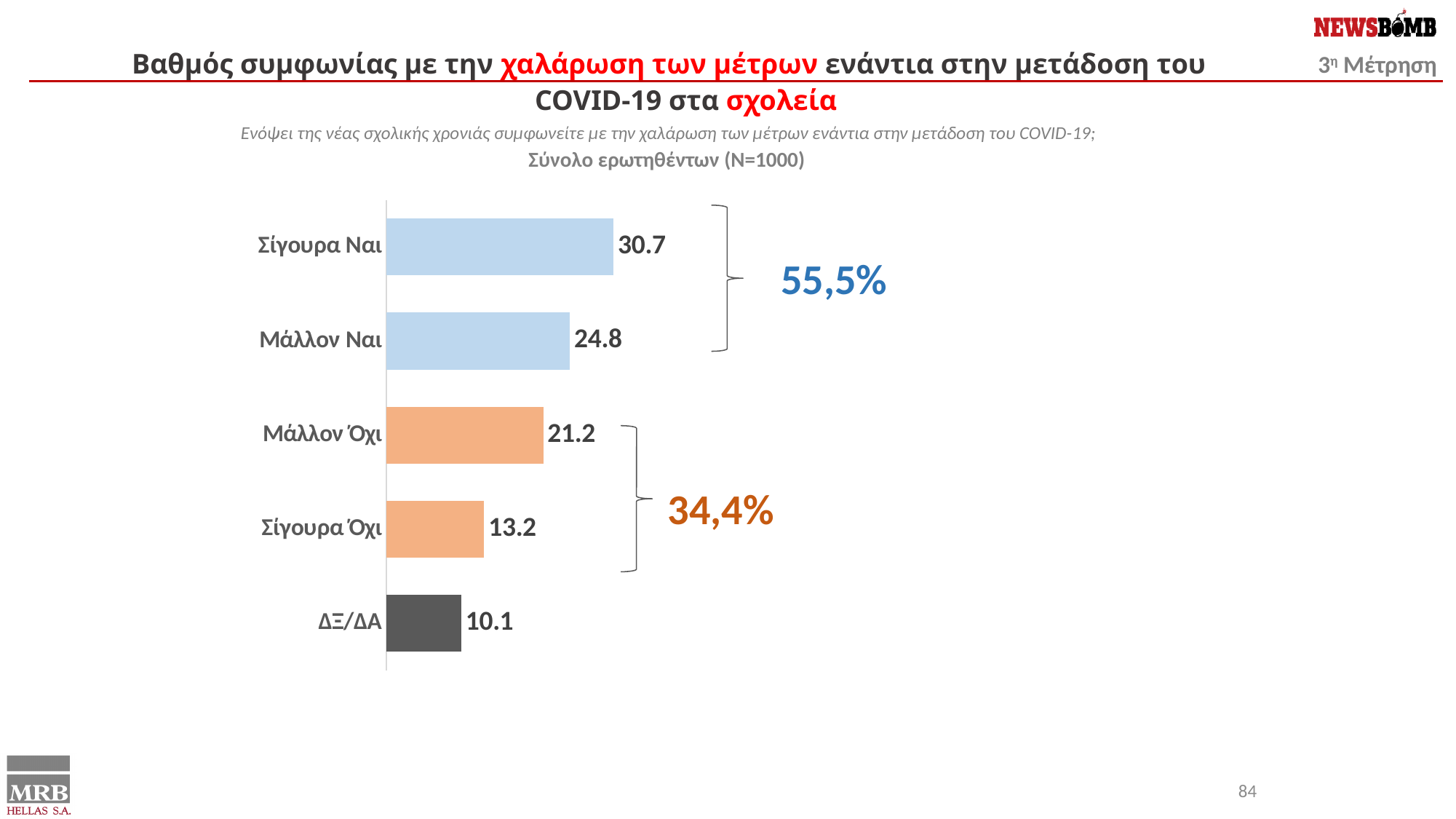
What combined percentage is shown next to the bracket grouping Μάλλον Όχι and Σίγουρα Όχι? 34,4% Which is larger, the value for Μάλλον Ναι or the value for Μάλλον Όχι? Μάλλον Ναι Which category has the lowest value? ΔΞ/ΔΑ What kind of chart is shown on the slide? bar chart What is the difference between the values for Μάλλον Όχι and Σίγουρα Όχι? 8.0 What combined percentage is shown next to the bracket grouping Σίγουρα Ναι and Μάλλον Ναι? 55,5% What is the value for Μάλλον Όχι? 21.2 Which category has the highest value? Σίγουρα Ναι What is the value for Σίγουρα Ναι? 30.7 How many categories are shown in the chart? 5 What is the value for ΔΞ/ΔΑ? 10.1 What is the difference between the values for Σίγουρα Ναι and Μάλλον Ναι? 5.9